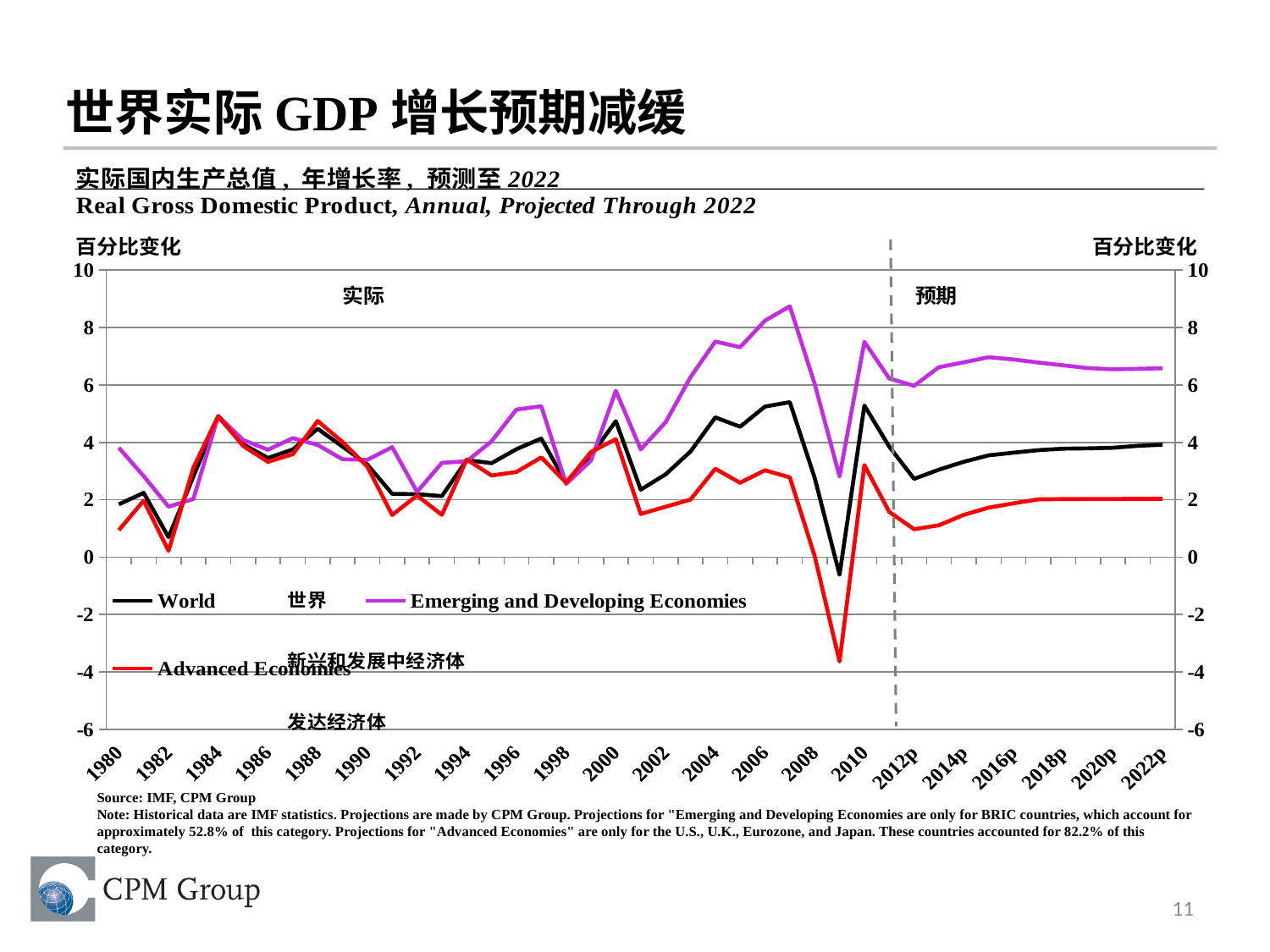
Is the value for Advanced Economies in 2012p greater or less than 2? less Is the value for Advanced Economies in 2009 greater or less than -2? less Is the value for Emerging and Developing Economies in 2007 greater or less than 8? greater In which year does the Advanced Economies series reach its lowest value? 2009 In 2022p, which is higher: Emerging and Developing Economies or Advanced Economies? Emerging and Developing Economies Which series is drawn in purple? Emerging and Developing Economies How many series does the legend list? 3 What kind of chart is shown on the slide? line chart What is the English title of the chart? Real Gross Domestic Product, Annual, Projected Through 2022 In which year does the Emerging and Developing Economies series reach its highest value? 2007